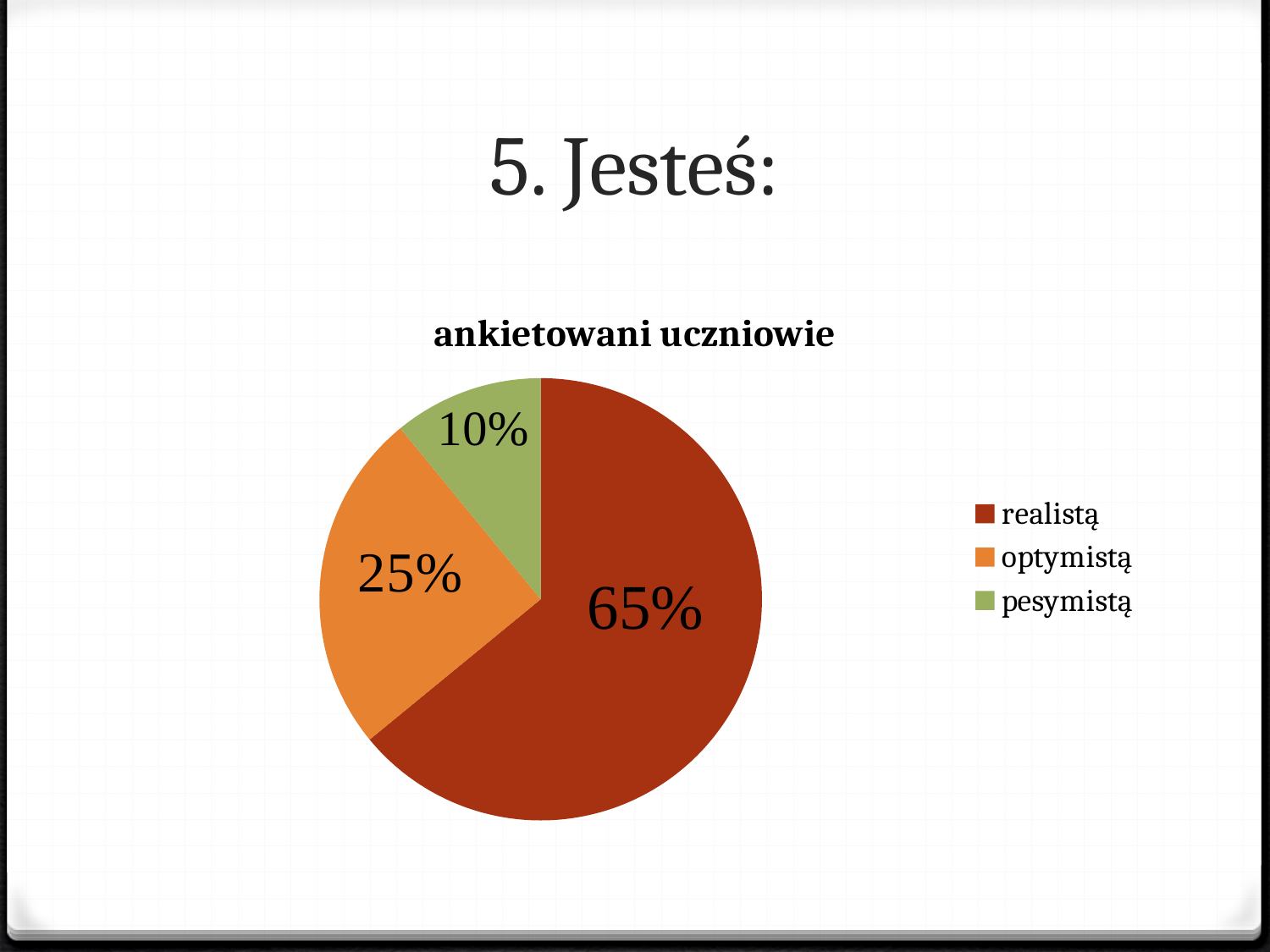
What share of the pie is labelled for optymistą? 25% Which category has the largest slice of the pie? realistą How many categories does the legend list? 3 What is the difference in percentage points between the realistą and optymistą slices? 40 What colour is the slice for pesymistą? green What share of the pie is labelled for pesymistą? 10% What is the chart's title? ankietowani uczniowie Which category has the smallest slice of the pie? pesymistą What kind of chart is shown on the slide? pie chart What share of the pie is labelled for realistą? 65% What is the difference in percentage points between the optymistą and pesymistą slices? 15 Which slice is larger, optymistą or pesymistą? optymistą